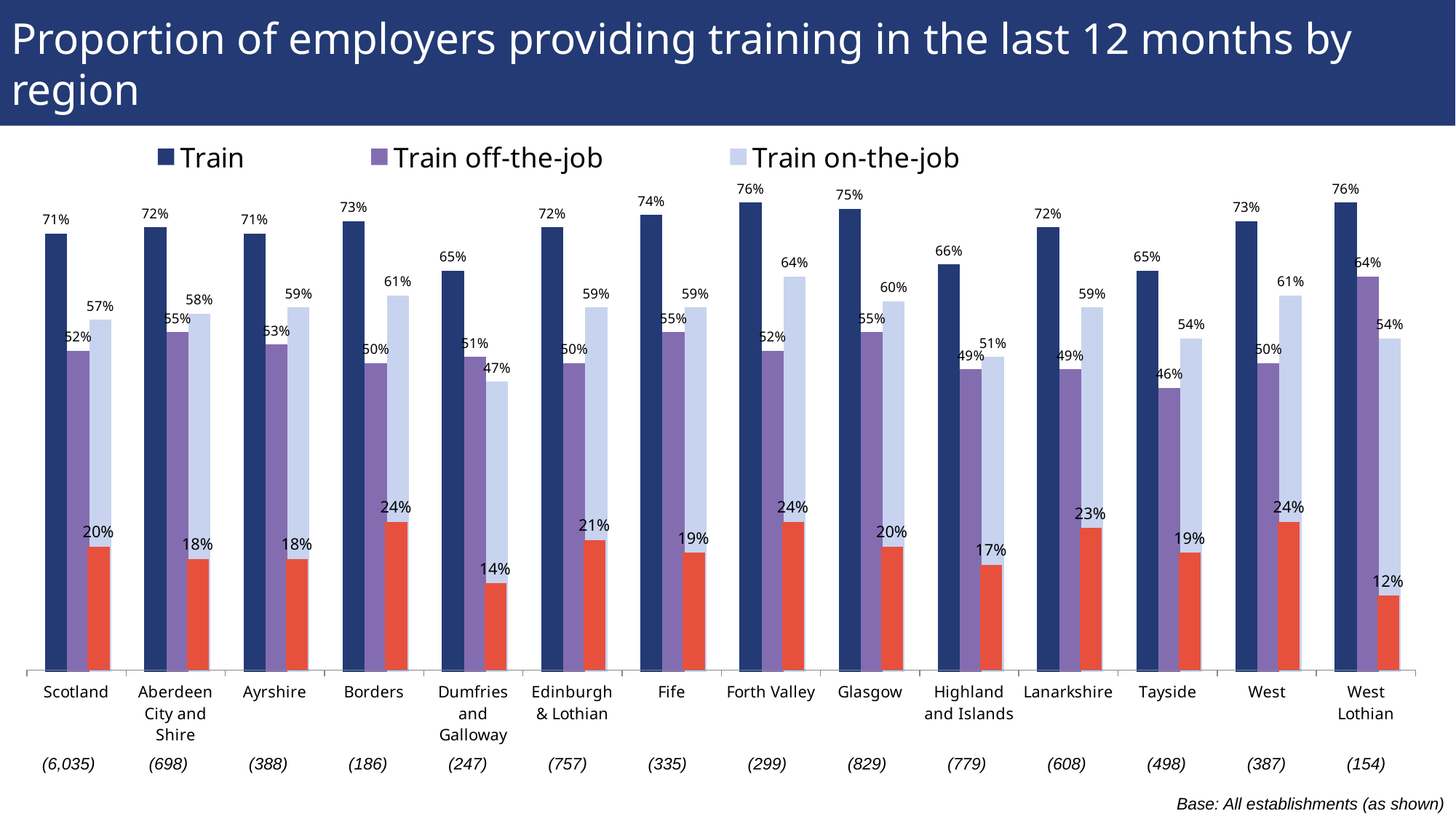
Which region has the lowest Train on-the-job value? Dumfries and Galloway What is the value of the Train series for Glasgow? 75% What is the difference between the Train value and the Train on-the-job value for Forth Valley? 12% Which region has the highest Train off-the-job value? West Lothian Which is larger for West Lothian: the Train off-the-job value or the Train on-the-job value? Train off-the-job Which region has the lowest Train off-the-job value? Tayside How many series does the legend list? 3 What kind of chart is shown on the slide? Bar chart What is the Train off-the-job value for West Lothian? 64% Which is larger for Tayside: the Train off-the-job value or the Train on-the-job value? Train on-the-job What is the Train on-the-job value for Dumfries and Galloway? 47% How many regions are shown on the x axis of the chart? 14